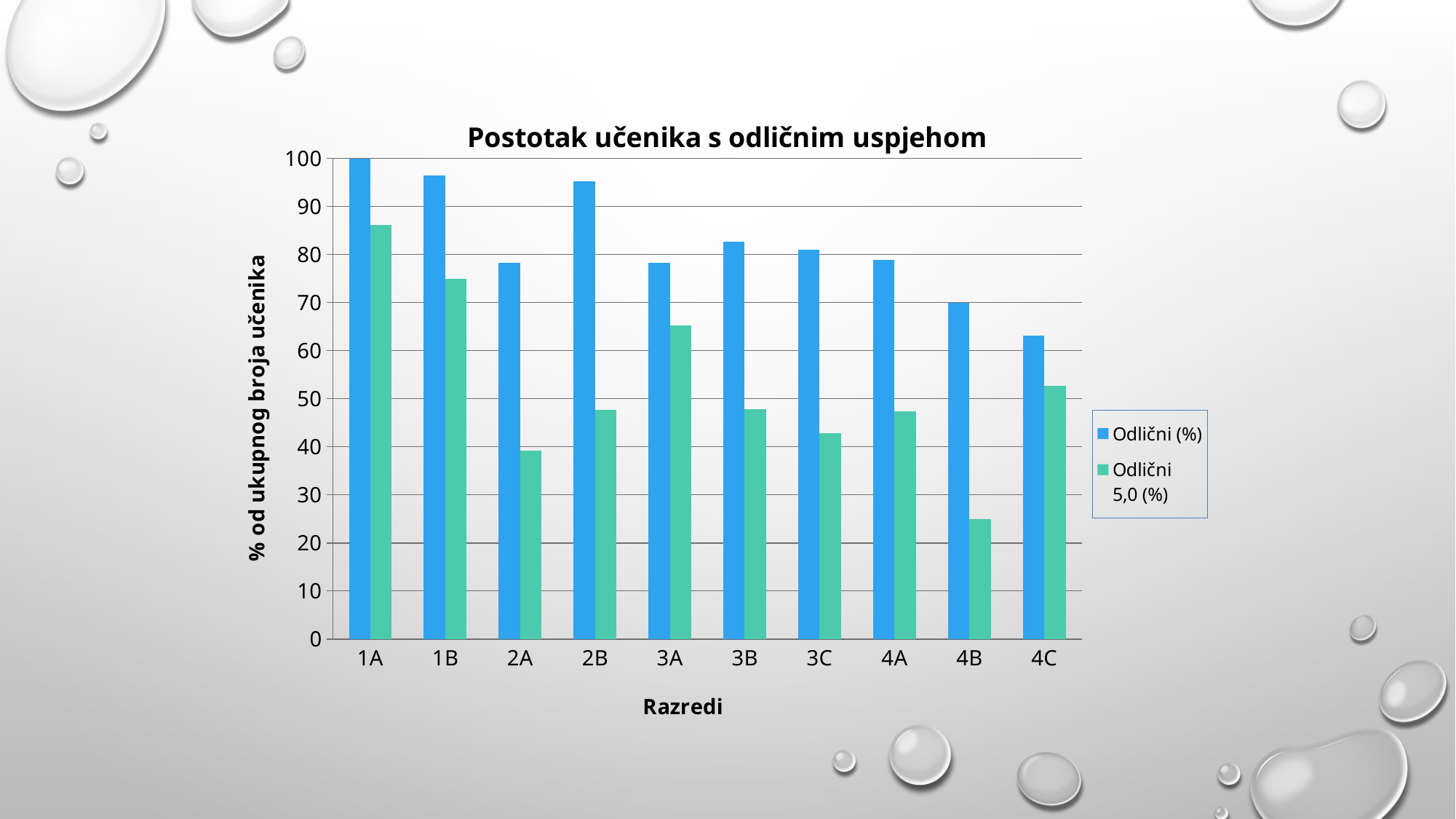
What is the value of Odlični (%) for class 1A? 100 What is the title of the chart? Postotak učenika s odličnim uspjehom Is the value of Odlični 5,0 (%) for class 4B greater or less than 30? less Which class has the lowest value for Odlični 5,0 (%)? 4B Which class has the lowest value for Odlični (%)? 4C Is the value of Odlični 5,0 (%) for class 3A greater or less than 60? greater Which is larger: Odlični 5,0 (%) for class 3A or for class 3B? 3A Do the Odlični (%) values generally rise or fall from class 1A to class 4C? fall How many classes (categories) are shown on the x axis? 10 What type of chart is shown on the slide? bar chart Which class has the highest value for Odlični (%)? 1A How many series does the legend list? 2